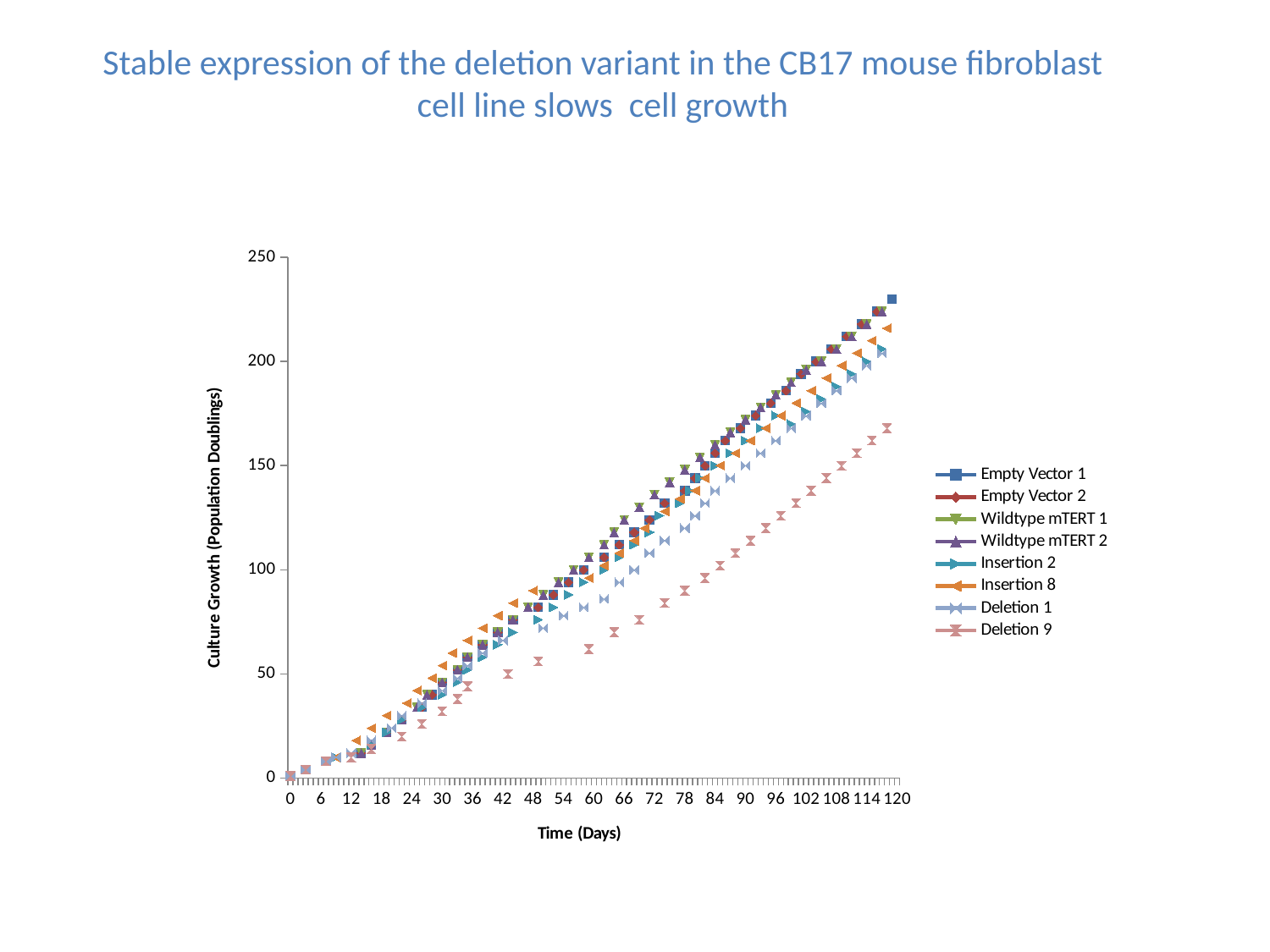
Is the value for Deletion 9 at day 120 greater or less than 150? greater Do the values for Empty Vector 1 rise or fall as time increases along the x axis? Rise Is the value for Deletion 9 at day 120 greater or less than 200? less Is the value for Empty Vector 1 at day 120 greater or less than 200? greater At day 120, which is larger: the value for Deletion 1 or the value for Deletion 9? Deletion 1 At day 120, which is larger: the value for Empty Vector 1 or the value for Deletion 9? Empty Vector 1 What kind of chart is shown on the slide? Line chart with markers What is the label of the x axis? Time (Days) Which series has the lowest value at day 120? Deletion 9 What is the label of the y axis? Culture Growth (Population Doublings) How many series does the legend list? 8